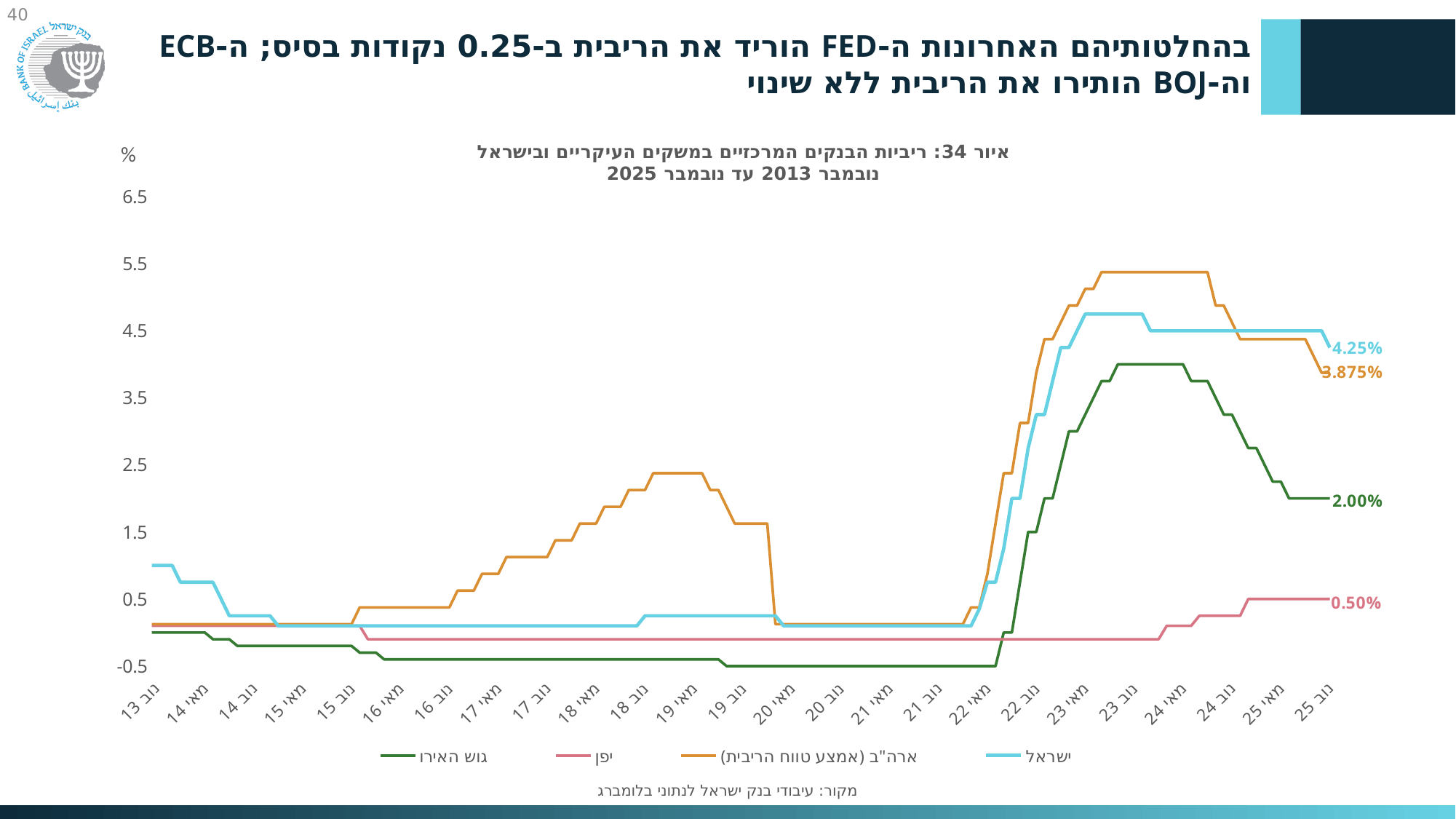
Is the peak value of the US series (orange) in 2023–2024 greater or less than 5? greater What is the latest value shown for the US (ארה"ב, midpoint of the range) at the end of the series? 3.875% What is the difference between the end values of Israel (4.25%) and the Eurozone (2.00%)? 2.25 percentage points Which series has the lowest value at the end of the chart (November 2025)? יפן (Japan) Does the Eurozone (green) series rise or fall between November 2023 and November 2025? Fall Which series has the highest value at the end of the chart (November 2025)? ישראל (Israel) What is the latest value shown for Israel (ישראל) at the end of the series? 4.25% What type of chart is shown on the slide? Line chart What is the latest value shown for the Eurozone (גוש האירו) at the end of the series? 2.00% What is the latest value shown for Japan (יפן) at the end of the series? 0.50% How many series does the legend list? 4 What is the figure number given in the chart title? איור 34